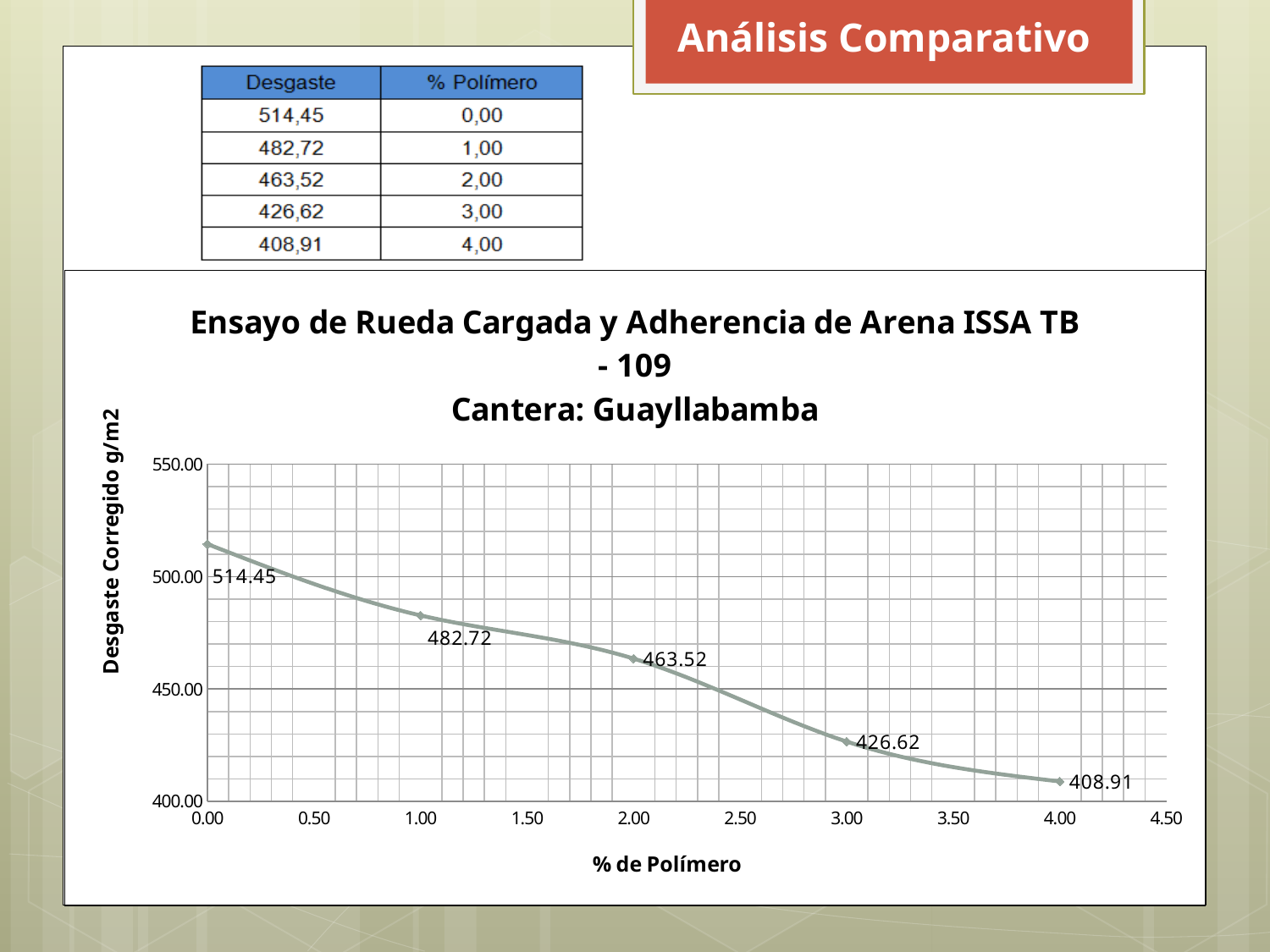
Does the Desgaste Corregido rise or fall as % de Polímero increases? fall What is the difference between the Desgaste Corregido values at 2.00 and 3.00 % de Polímero? 36.90 What is the Desgaste Corregido value at 4.00 % de Polímero? 408.91 What is the Desgaste Corregido value at 2.00 % de Polímero? 463.52 What is the Desgaste Corregido value at 0.00 % de Polímero? 514.45 What kind of chart is shown on the slide? line chart What is the difference between the Desgaste Corregido values at 0.00 and 1.00 % de Polímero? 31.73 Is the Desgaste Corregido value at 3.00 % de Polímero greater or less than 450.00? less At which % de Polímero is the Desgaste Corregido highest? 0.00 Which has a larger Desgaste Corregido value: 1.00 % de Polímero or 3.00 % de Polímero? 1.00 % de Polímero How many data points are plotted on the chart? 5 At which % de Polímero is the Desgaste Corregido lowest? 4.00